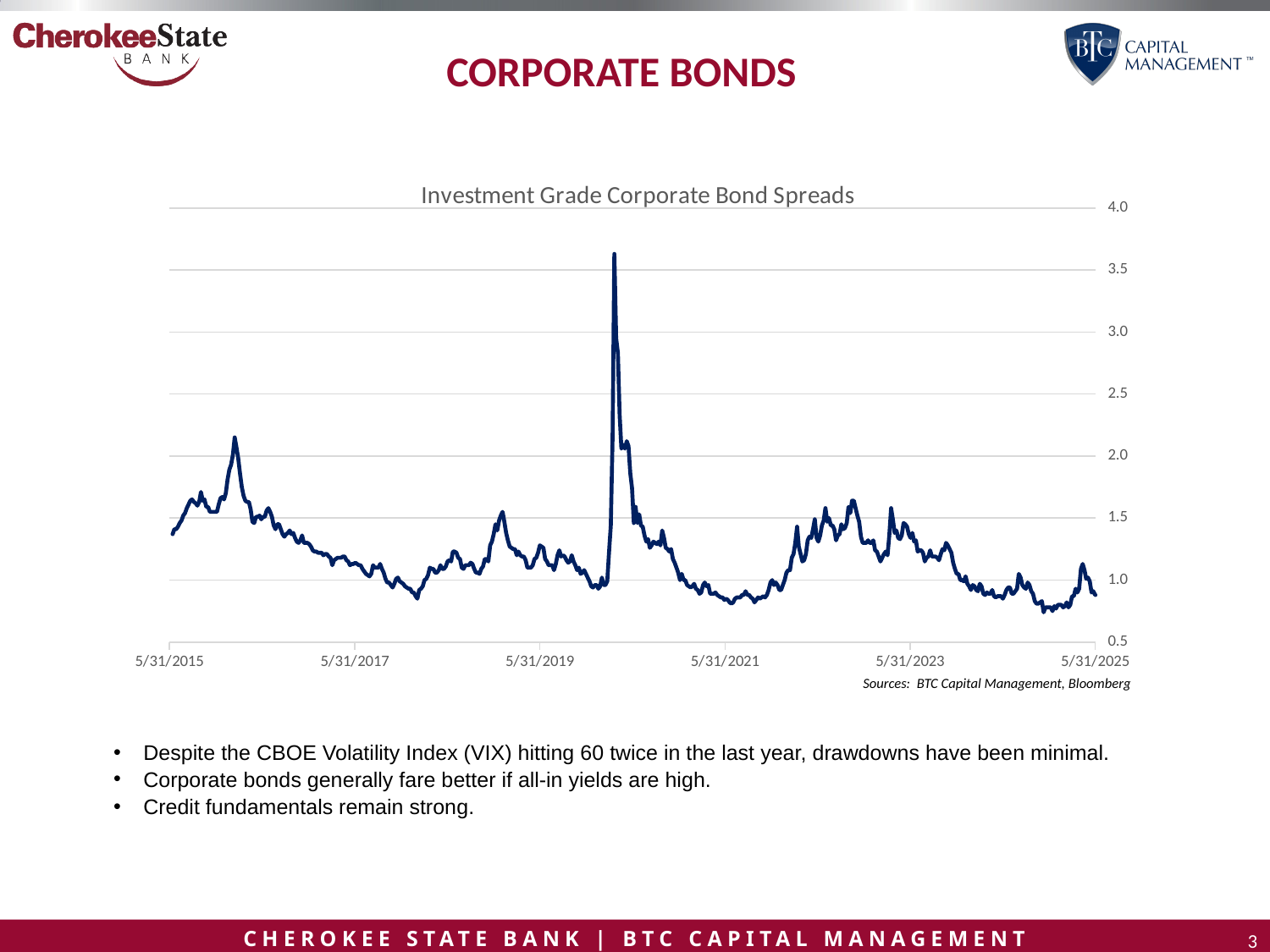
Between which two x-axis labels does the highest spike in the series occur? 5/31/2019 and 5/31/2021 Is the peak value of the spread series greater or less than 3.0? greater What is the last date label on the x axis? 5/31/2025 Is the value at 5/31/2025 greater or less than 1.0? less Is the value at the start of the series (5/31/2015) larger or smaller than the value at the end (5/31/2025)? larger How many date labels are shown on the x axis? 6 Overall, does the series end higher or lower than it starts? lower What is the highest value shown on the y axis? 4.0 Is the value at 5/31/2021 greater or less than 1.5? less What kind of chart is shown on the slide? Line chart What is the title of the chart? Investment Grade Corporate Bond Spreads